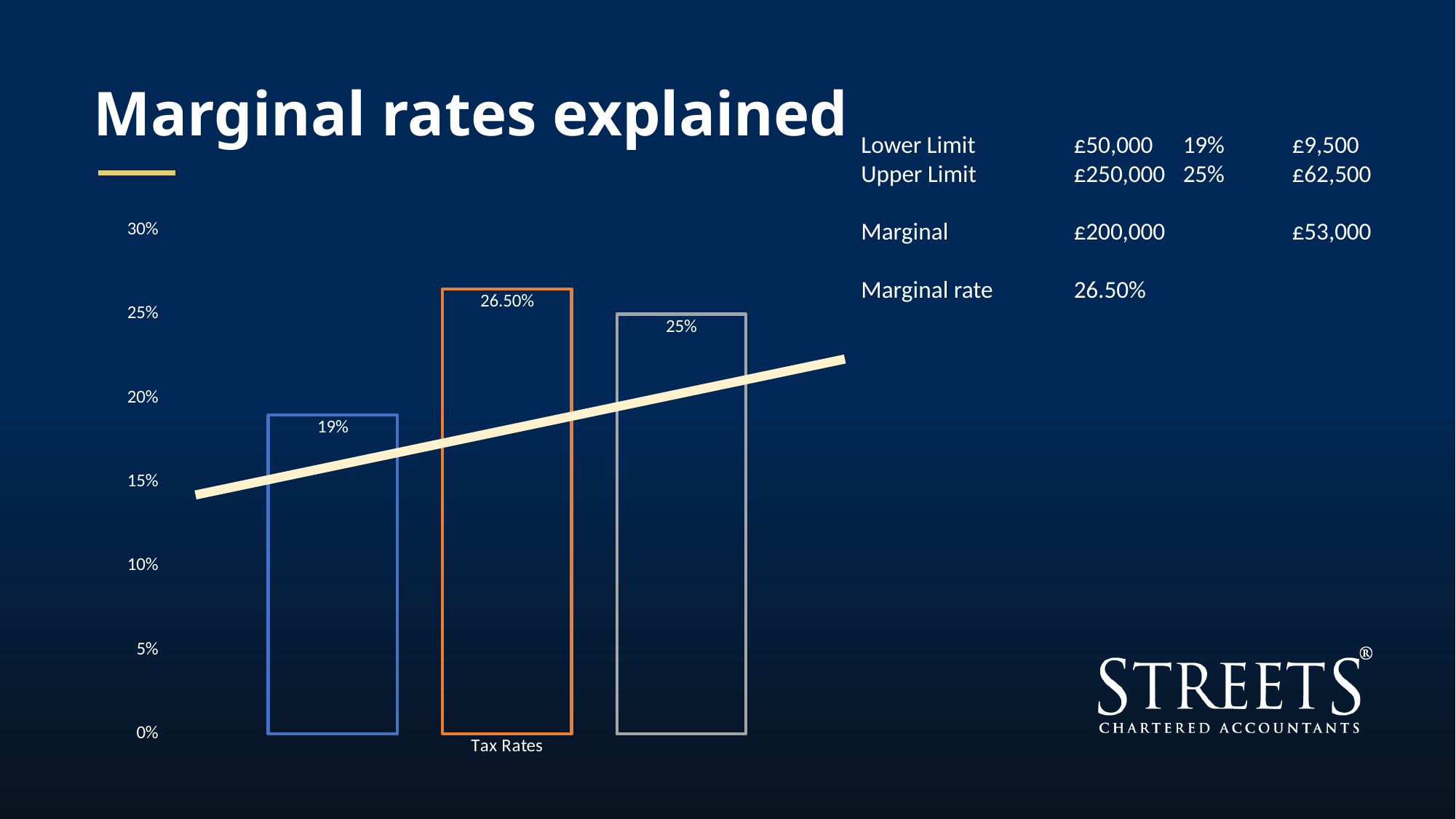
Which bar has the highest value? the middle (orange) bar, 26.50% Which is larger, the value of the orange bar or the value of the grey bar? the orange bar (26.50%) How many bars are plotted in the chart? 3 What value is labelled on the first (blue) bar? 19% Is the value of the first (blue) bar greater or less than 20%? less What is the difference between the orange bar's value and the blue bar's value? 7.50% What is the label shown beneath the bars on the x axis? Tax Rates Which bar has the lowest value? the first (blue) bar, 19% What value is labelled on the third (grey) bar? 25% What kind of chart is shown on the slide? bar chart What is the difference between the grey bar's value and the blue bar's value? 6% What value is labelled on the middle (orange) bar? 26.50%